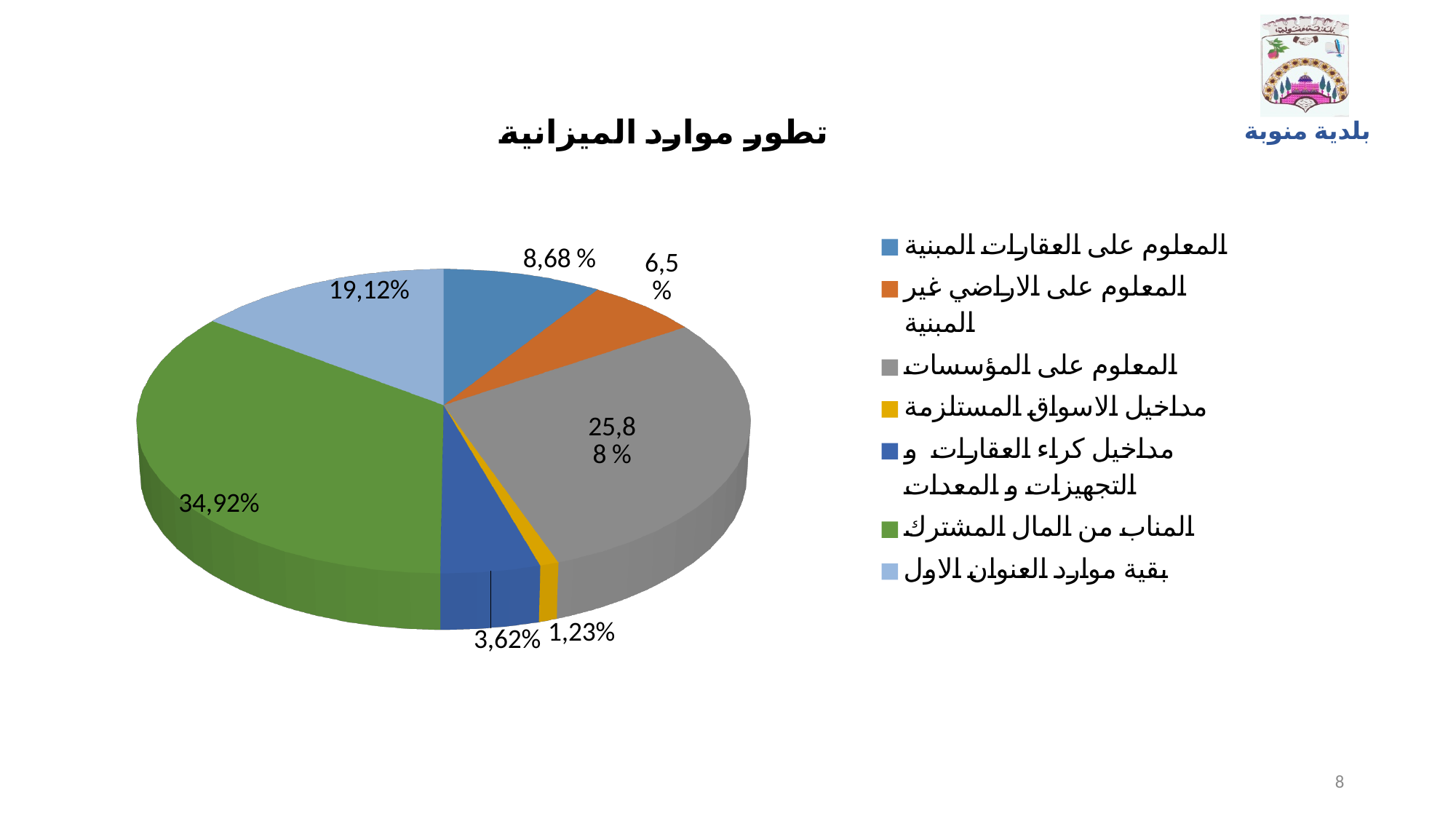
What type of chart is shown on the slide? Pie chart What is the title of the chart? تطور موارد الميزانية What is the value shown for مداخيل كراء العقارات و التجهيزات و المعدات? 3,62% What is the value shown for بقية موارد العنوان الاول? 19,12% Which category has the smallest share of the pie? مداخيل الاسواق المستلزمة Which is larger: المعلوم على العقارات المبنية or المعلوم على الاراضي غير المبنية? المعلوم على العقارات المبنية What is the value shown for مداخيل الاسواق المستلزمة? 1,23% How many slices does the pie chart have? 7 What is the value shown for المناب من المال المشترك? 34,92% What is the difference between the shares of المناب من المال المشترك and بقية موارد العنوان الاول? 15,80% Which category has the largest share of the pie? المناب من المال المشترك What is the value shown for المعلوم على العقارات المبنية? 8,68 %